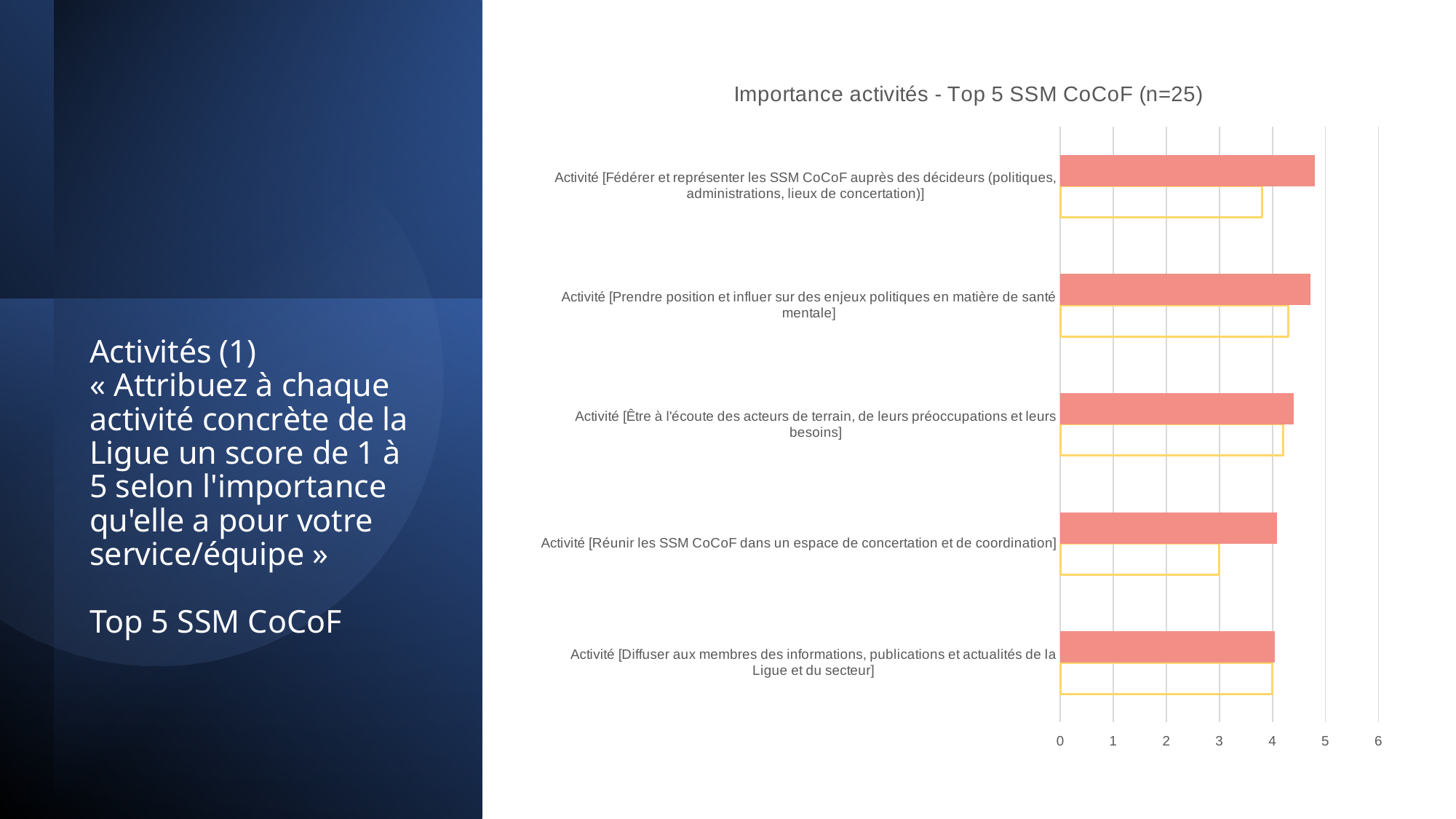
What is the sample size (n) indicated in the chart title? 25 Is the red bar for 'Activité [Prendre position et influer sur des enjeux politiques en matière de santé mentale]' greater or less than 5? less For 'Activité [Réunir les SSM CoCoF dans un espace de concertation et de coordination]', which bar is larger: the red bar or the yellow bar? the red bar Which is larger: the yellow bar for 'Activité [Fédérer et représenter les SSM CoCoF auprès des décideurs (politiques, administrations, lieux de concertation)]' or the yellow bar for 'Activité [Prendre position et influer sur des enjeux politiques en matière de santé mentale]'? Activité [Prendre position et influer sur des enjeux politiques en matière de santé mentale] What type of chart is shown on the slide? bar chart Which is larger: the red bar for 'Activité [Fédérer et représenter les SSM CoCoF auprès des décideurs (politiques, administrations, lieux de concertation)]' or the red bar for 'Activité [Réunir les SSM CoCoF dans un espace de concertation et de coordination]'? Activité [Fédérer et représenter les SSM CoCoF auprès des décideurs (politiques, administrations, lieux de concertation)] Is the yellow bar for 'Activité [Fédérer et représenter les SSM CoCoF auprès des décideurs (politiques, administrations, lieux de concertation)]' greater or less than 4? less Is the yellow bar for 'Activité [Prendre position et influer sur des enjeux politiques en matière de santé mentale]' greater or less than 4? greater Which activity has the lowest yellow bar? Activité [Réunir les SSM CoCoF dans un espace de concertation et de coordination] How many activities (categories) are plotted in the chart? 5 What is the title of the chart? Importance activités - Top 5 SSM CoCoF (n=25)